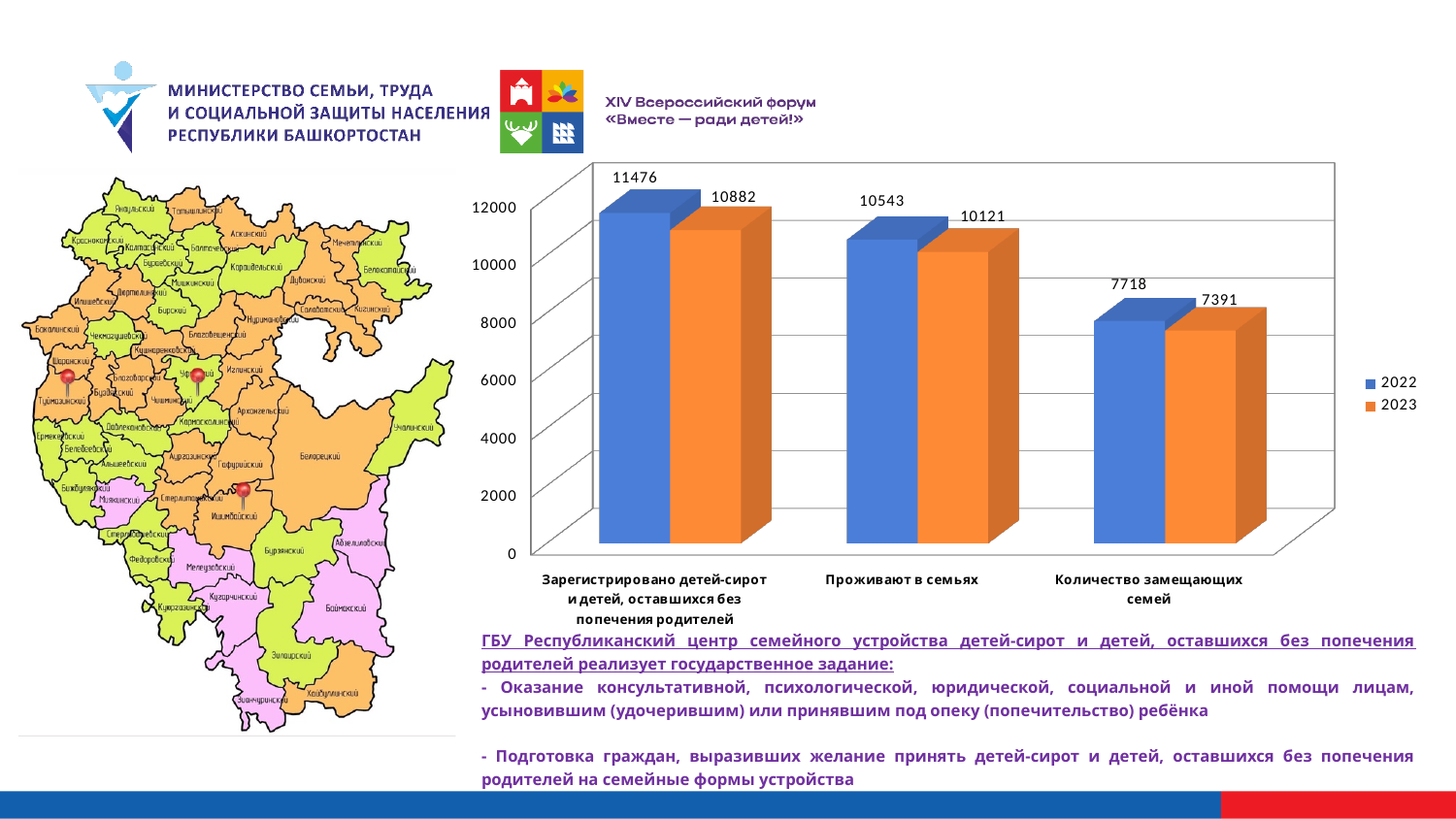
Which category has the lowest 2022 value? Количество замещающих семей What type of chart is shown on the slide? bar chart What is the 2023 value for "Количество замещающих семей"? 7391 What is the 2022 value for "Проживают в семьях"? 10543 How many series does the chart legend list? 2 What is the difference between the 2022 and 2023 values for "Количество замещающих семей"? 327 Which category has the highest 2023 value? Зарегистрировано детей-сирот и детей, оставшихся без попечения родителей How many categories are shown on the x axis of the chart? 3 Which is larger for "Зарегистрировано детей-сирот и детей, оставшихся без попечения родителей": the 2022 value or the 2023 value? 2022 What is the 2023 value for "Проживают в семьях"? 10121 Is the 2023 value for "Количество замещающих семей" greater or less than 8000? less What is the 2022 value for "Зарегистрировано детей-сирот и детей, оставшихся без попечения родителей"? 11476